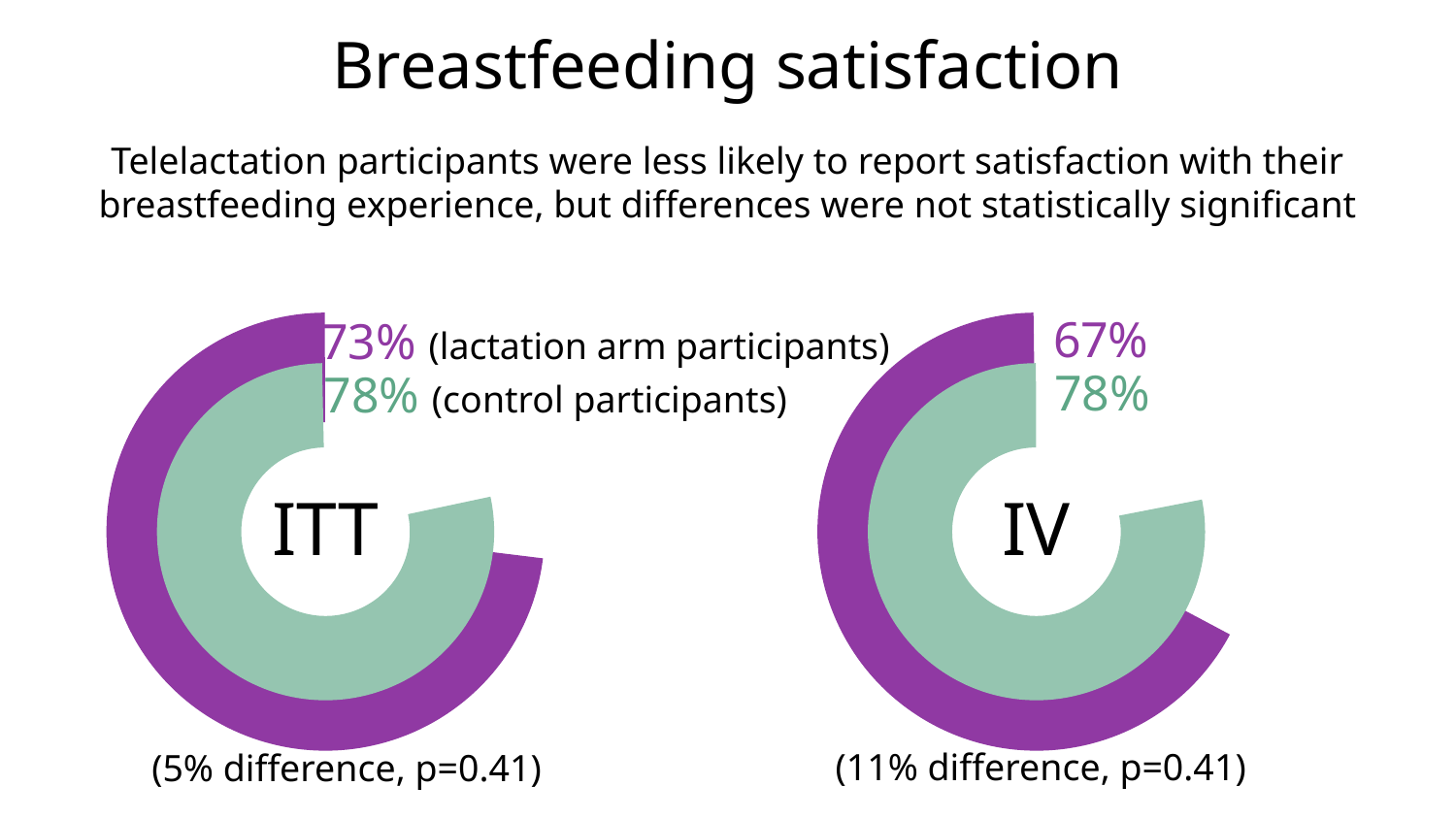
What colour represents the lactation arm participants in the charts? purple In the IV chart, which group has the higher satisfaction rate, lactation arm participants or control participants? control participants In the ITT chart, what percentage of lactation arm participants reported breastfeeding satisfaction? 73% How many charts are shown on the slide? 2 In the IV chart, what percentage of control participants reported breastfeeding satisfaction? 78% In the IV chart, what is the difference between the control participants' and lactation arm participants' satisfaction rates? 11% In the IV chart, what percentage of lactation arm participants reported breastfeeding satisfaction? 67% In the ITT chart, what is the difference between the control participants' and lactation arm participants' satisfaction rates? 5% Which chart shows the lower satisfaction rate for lactation arm participants, ITT or IV? IV What kind of chart is used to show the ITT results? donut chart In the ITT chart, which group has the lower satisfaction rate? lactation arm participants In the ITT chart, what percentage of control participants reported breastfeeding satisfaction? 78%